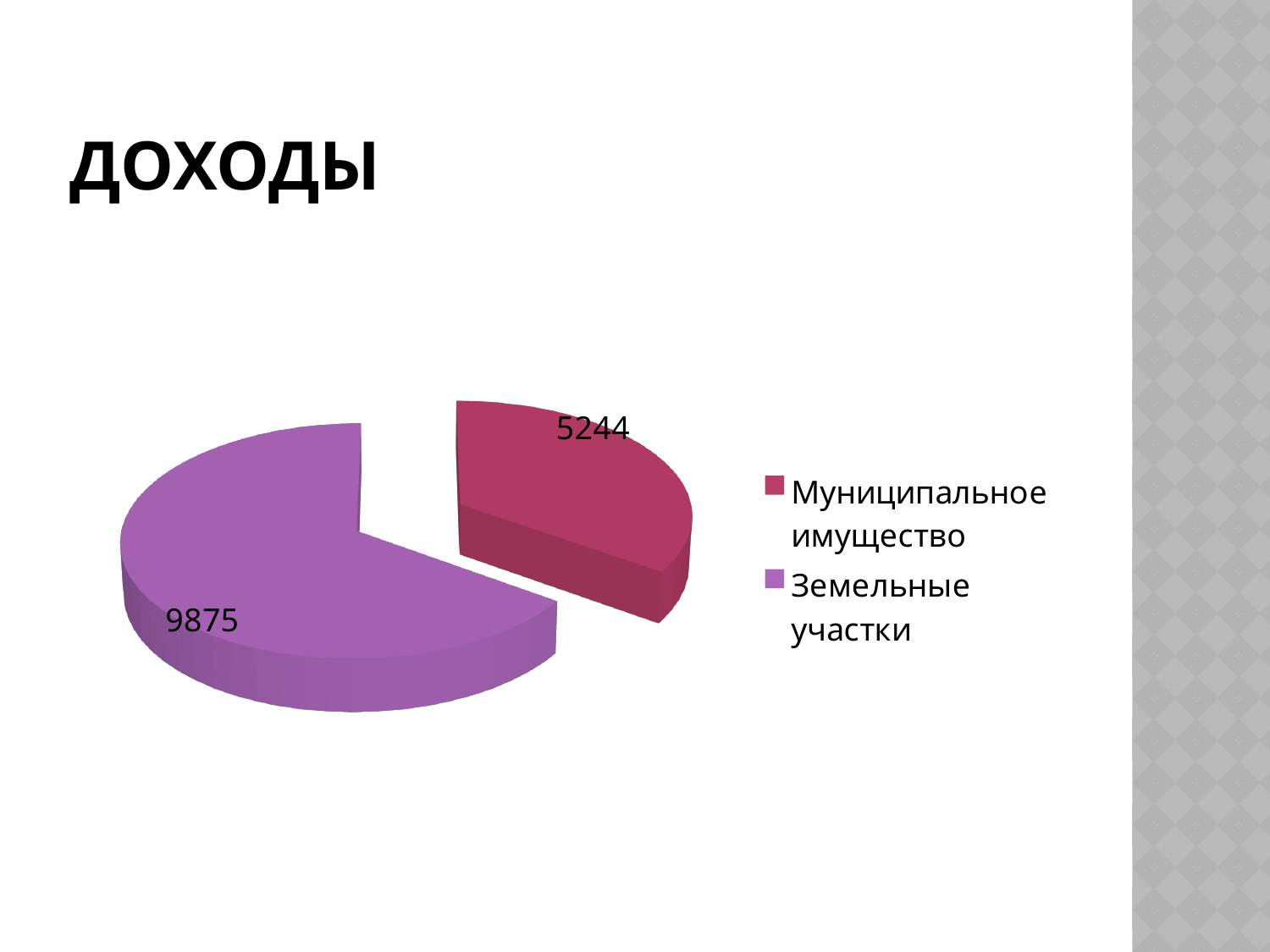
What colour is the slice for Муниципальное имущество? Red What kind of chart is shown on the slide? Pie chart How many slices does the pie chart have? 2 How many entries does the legend list? 2 Which category has the largest slice of the pie? Земельные участки What is the difference between the values for Земельные участки and Муниципальное имущество? 4631 Which category has the smallest slice of the pie? Муниципальное имущество What is the value for Муниципальное имущество? 5244 What is the total of the two values shown in the pie chart? 15119 Which is larger, the value for Муниципальное имущество or the value for Земельные участки? Земельные участки What is the value for Земельные участки? 9875